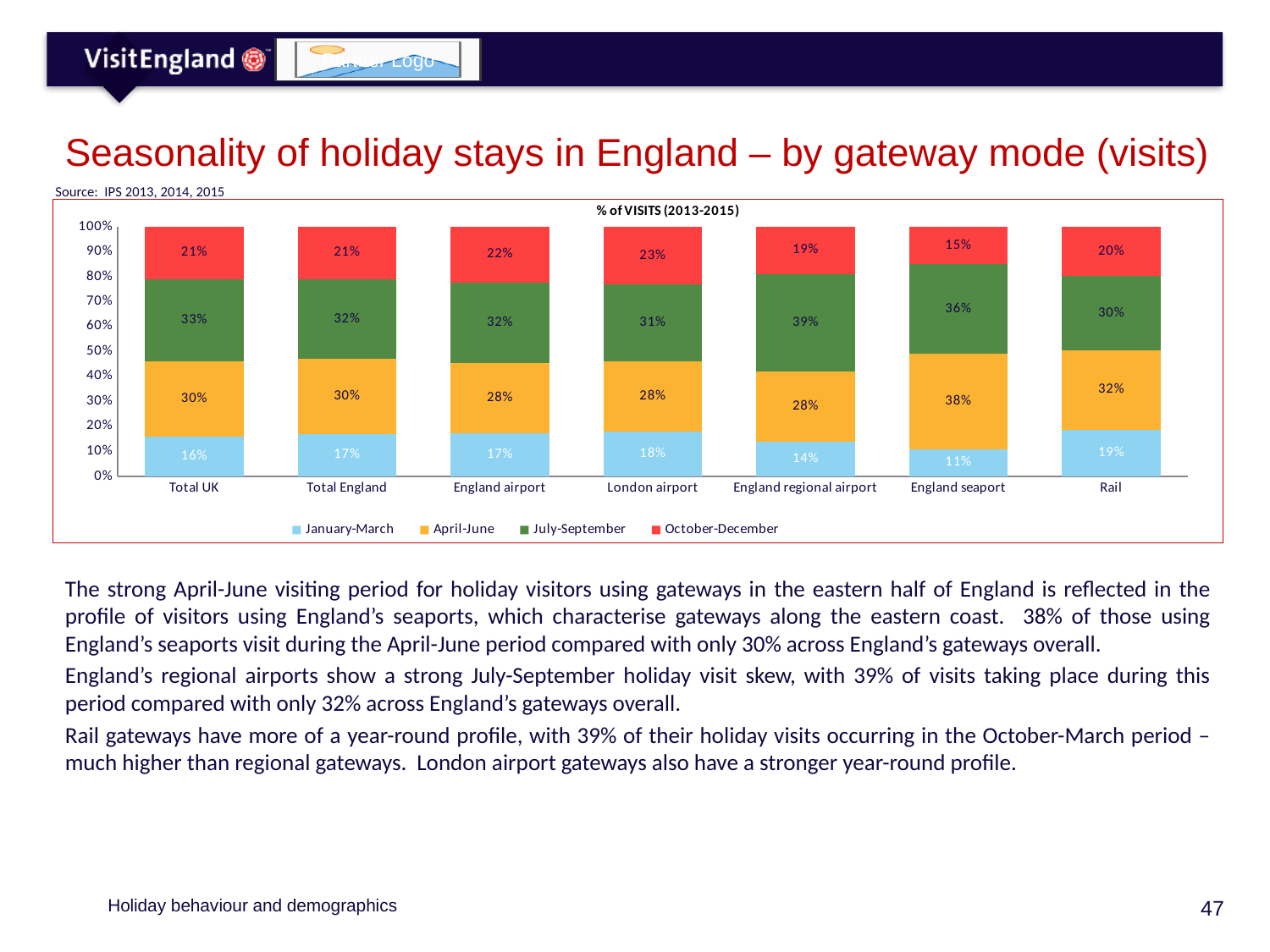
What is the April-June share of visits for England seaport? 38% How many series does the legend list? 4 Which gateway mode has the lowest October-December share of visits? England seaport What kind of chart is shown on the slide? Stacked bar chart Which is larger: the July-September share for England regional airport or for Rail? England regional airport Which gateway mode has the highest April-June share of visits? England seaport What is the July-September share of visits for England regional airport? 39% How many gateway mode categories are shown on the x axis? 7 Which gateway mode has the lowest January-March share of visits? England seaport What is the October-December share of visits for London airport? 23% What is the difference between the April-June share for England seaport and for Total England? 8 percentage points What is the January-March share of visits for Rail? 19%